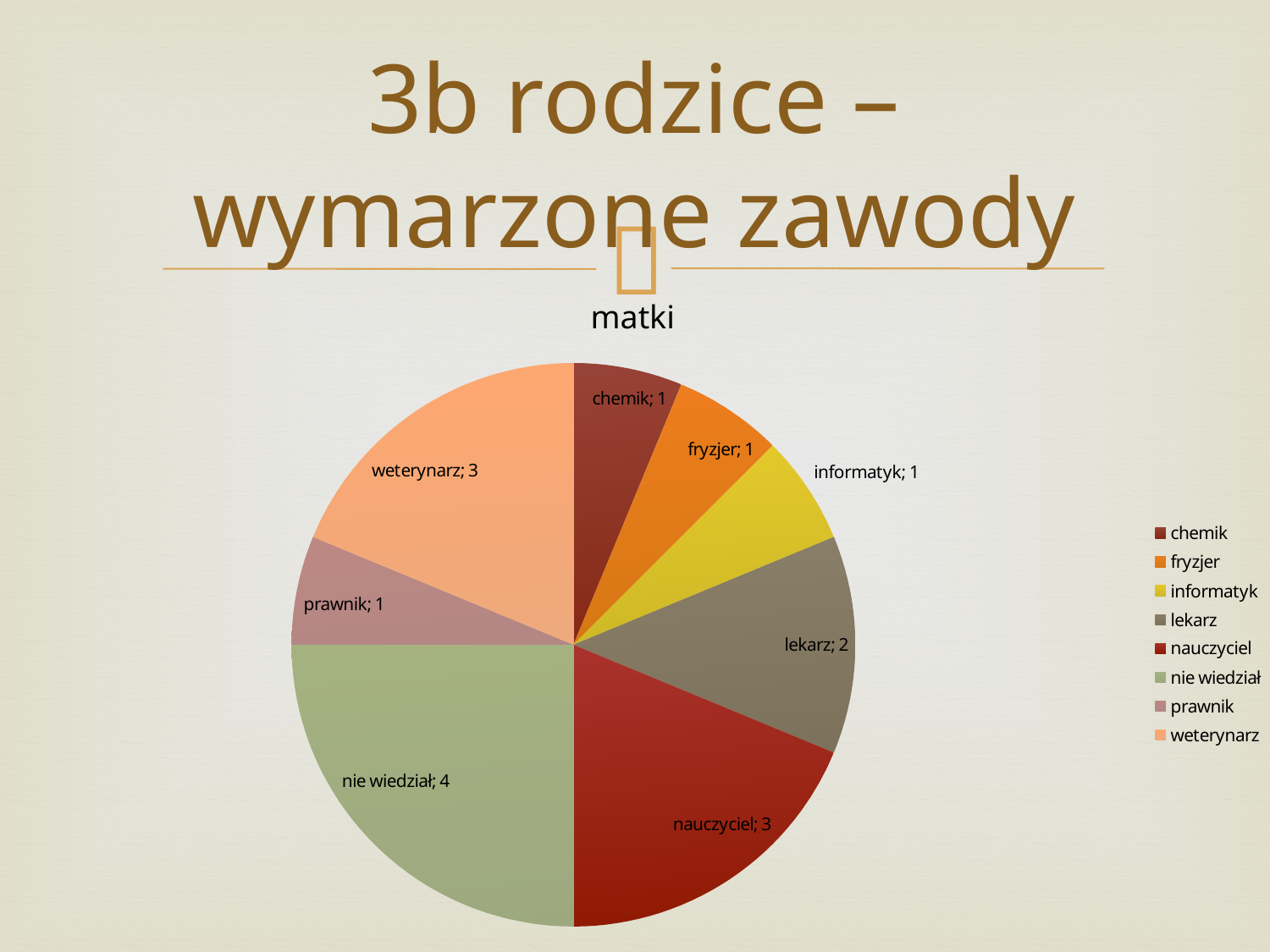
What is the value for weterynarz? 3 What is the difference between the values for nie wiedział and nauczyciel? 1 Which is larger, the value for lekarz or the value for prawnik? lekarz Which category has the largest slice? nie wiedział What kind of chart is shown on the slide? pie chart Which category is shown in yellow in the legend? informatyk What share of the pie does nie wiedział represent? 25% What is the title of the chart? matki How many slices does the pie chart have? 8 What is the value for nie wiedział? 4 What is the value for lekarz? 2 What is the total of all the values in the pie chart? 16